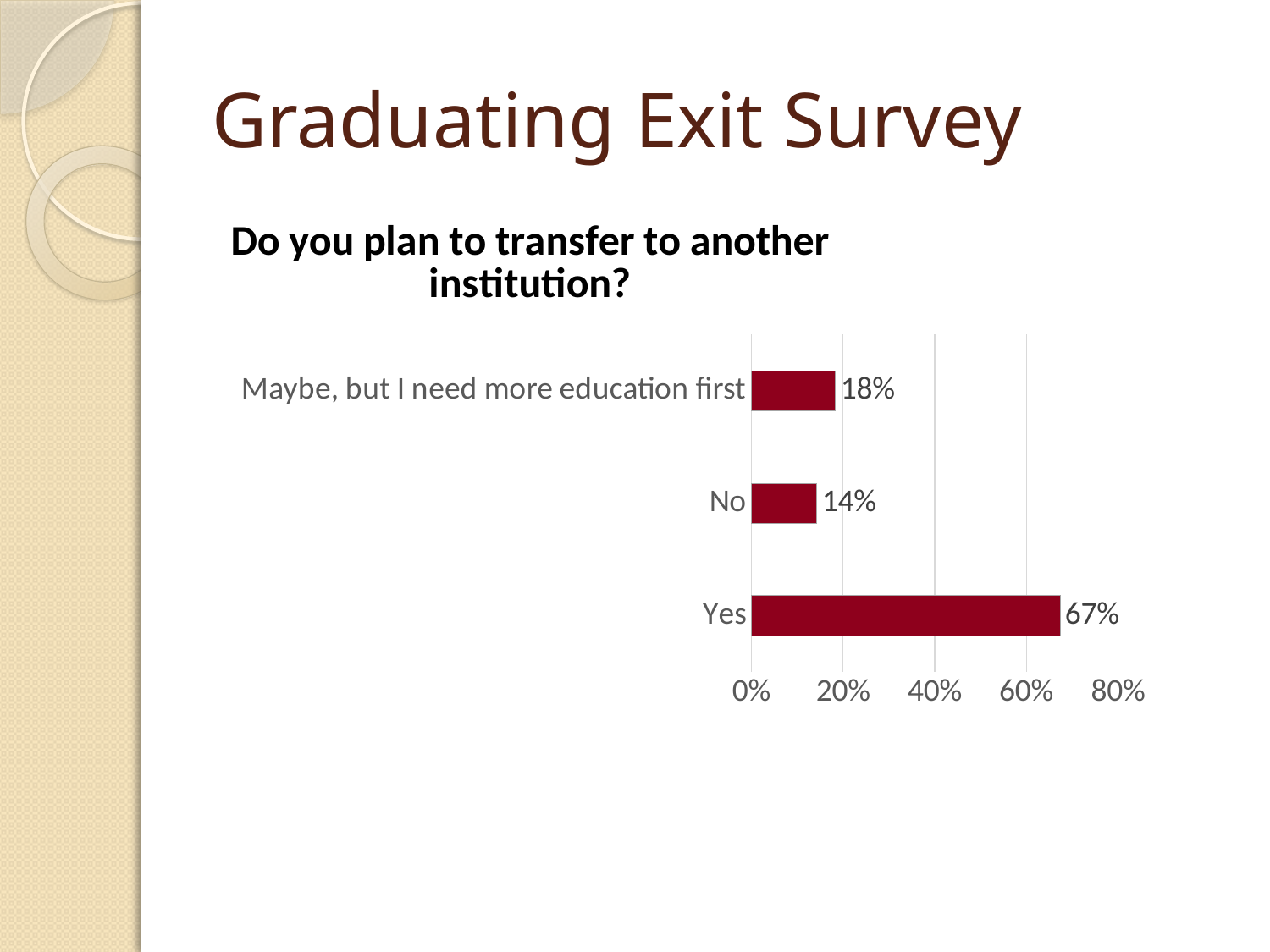
What percentage of respondents answered "Yes" to planning to transfer to another institution? 67% Which response category has the lowest percentage? No What is the difference in percentage points between "Maybe, but I need more education first" and "No"? 4 What is the title of the chart? Do you plan to transfer to another institution? What kind of chart is shown on the slide? Bar chart What is the difference in percentage points between the "Yes" and "No" responses? 53 Which response category has the highest percentage? Yes How many response categories are shown in the chart? 3 Is the value for "Yes" greater or less than 60%? greater What percentage of respondents answered "No"? 14% Which is larger, the percentage for "Maybe, but I need more education first" or for "No"? Maybe, but I need more education first What percentage of respondents answered "Maybe, but I need more education first"? 18%